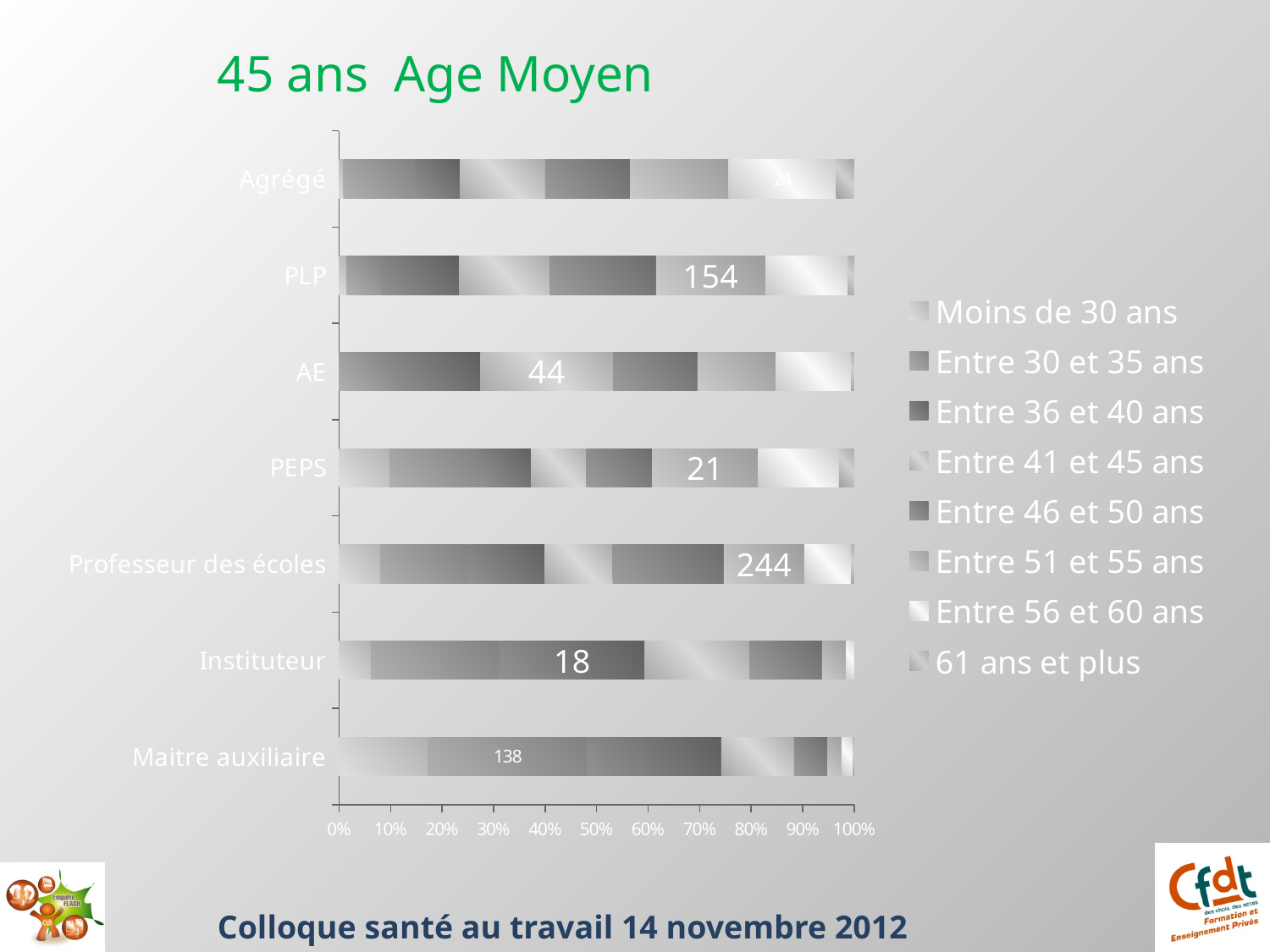
What data label is printed on the PEPS bar? 21 What data label is printed on the AE bar? 44 What data label is printed on the PLP bar? 154 How many series does the legend list? 8 What kind of chart is shown on the slide? stacked bar chart What data label is printed on the Professeur des écoles bar? 244 How many categories (teacher types) are plotted on the vertical axis? 7 What is the title of the chart? 45 ans Age Moyen What data label is printed on the Agrégé bar? 24 What is the first entry in the legend? Moins de 30 ans What data label is printed on the Maitre auxiliaire bar? 138 What data label is printed on the Instituteur bar? 18